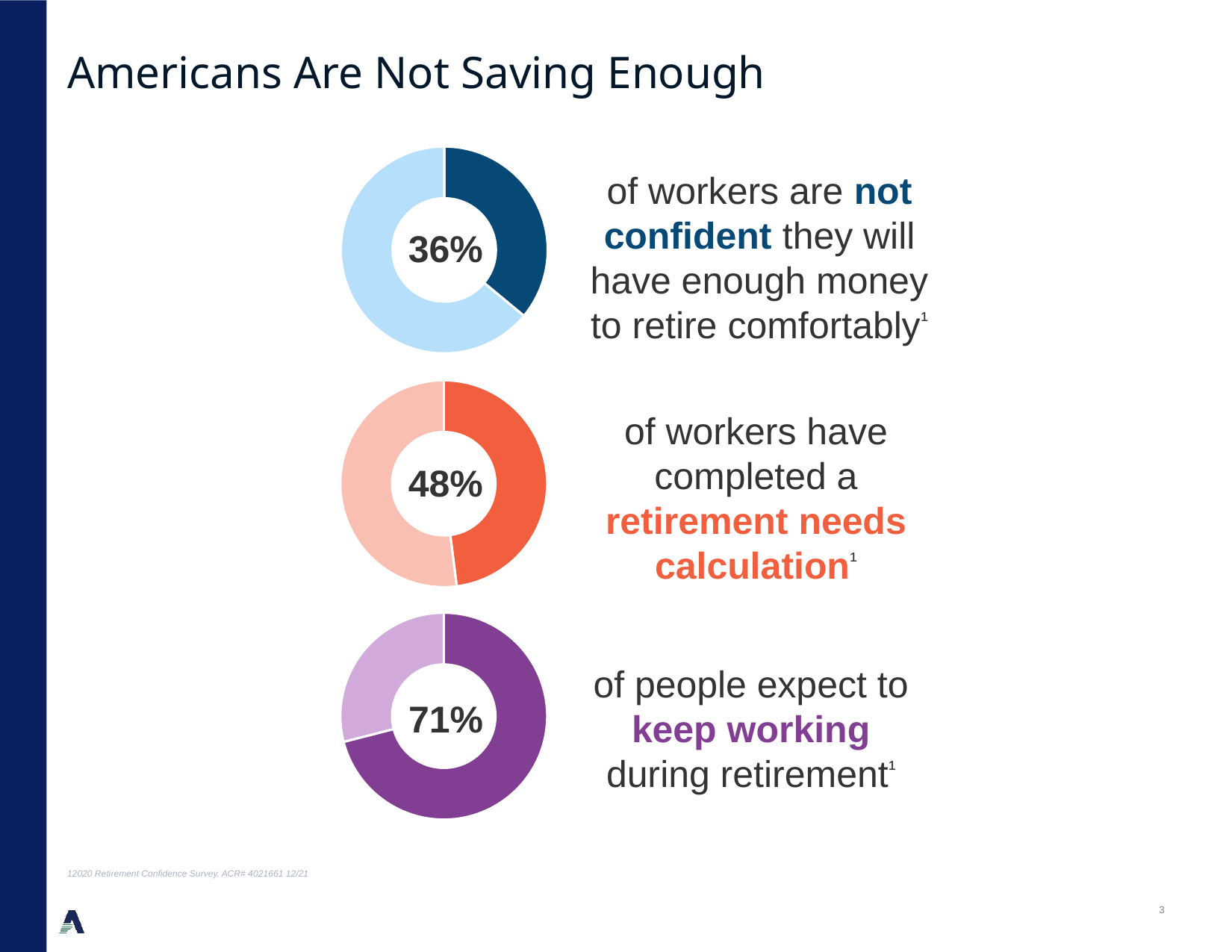
In the middle donut chart, what percentage of workers have completed a retirement needs calculation? 48% How many donut charts are shown on the slide? 3 In the top donut chart, what percentage of workers are not confident they will have enough money to retire comfortably? 36% Is the value shown in the middle donut chart greater or less than 50%? less In the bottom donut chart, what percentage of people expect to keep working during retirement? 71% Which is larger: the percentage of workers who completed a retirement needs calculation or the percentage of people who expect to keep working during retirement? Keep working during retirement (71%) What kind of chart is used to show the 36% statistic on the slide? Donut chart What is the difference between the percentage in the middle donut chart (48%) and the top donut chart (36%)? 12 percentage points Which of the three donut charts shows the highest percentage? The bottom chart (keep working during retirement), 71% Which of the three donut charts shows the lowest percentage? The top chart (not confident about retiring comfortably), 36% What colour is the highlighted slice in the bottom donut chart? Purple What is the difference between the percentage in the bottom donut chart (71%) and the top donut chart (36%)? 35 percentage points